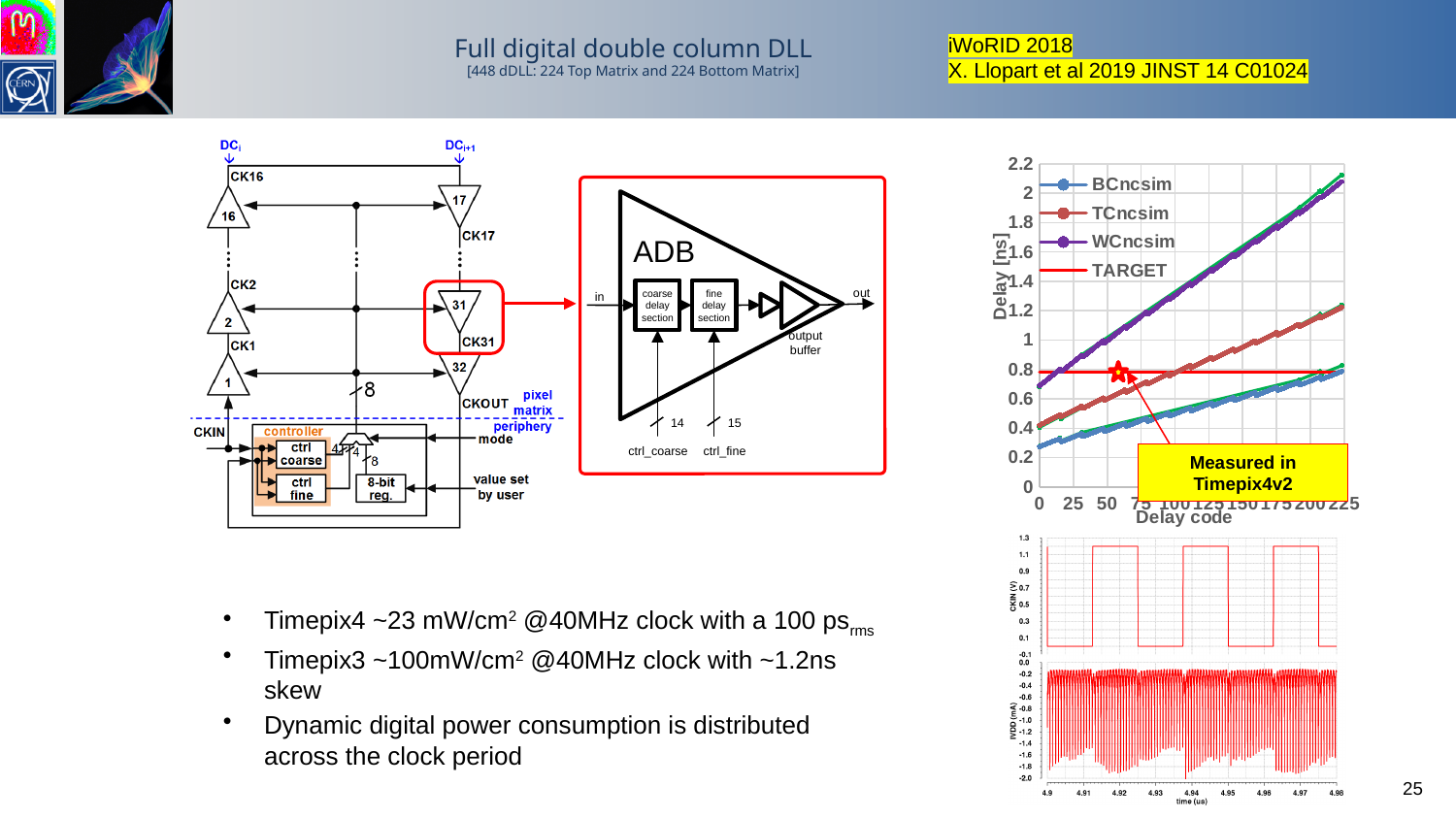
In the Delay vs Delay code chart, is the TCncsim delay at delay code 225 greater or less than 1? greater In the Delay vs Delay code chart, is the WCncsim delay at delay code 225 greater or less than 1.8? greater In the Delay vs Delay code chart, how many series does the legend list? 4 In the Delay vs Delay code chart, do the BCncsim, TCncsim and WCncsim values rise or fall as the delay code increases? rise In the Delay vs Delay code chart, which series has the highest delay at delay code 225? WCncsim In the Delay vs Delay code chart, what is the highest value shown on the y axis? 2.2 In the Delay vs Delay code chart, what is the label of the y axis? Delay [ns] In the Delay vs Delay code chart, which is larger at delay code 150: the WCncsim delay or the TCncsim delay? WCncsim In the Delay vs Delay code chart, which series has the lowest delay at delay code 225? BCncsim In the Delay vs Delay code chart, is the BCncsim delay at delay code 100 greater or less than 0.8? less In the Delay vs Delay code chart, what is the label of the x axis? Delay code In the Delay vs Delay code chart, what kind of chart is it? line chart